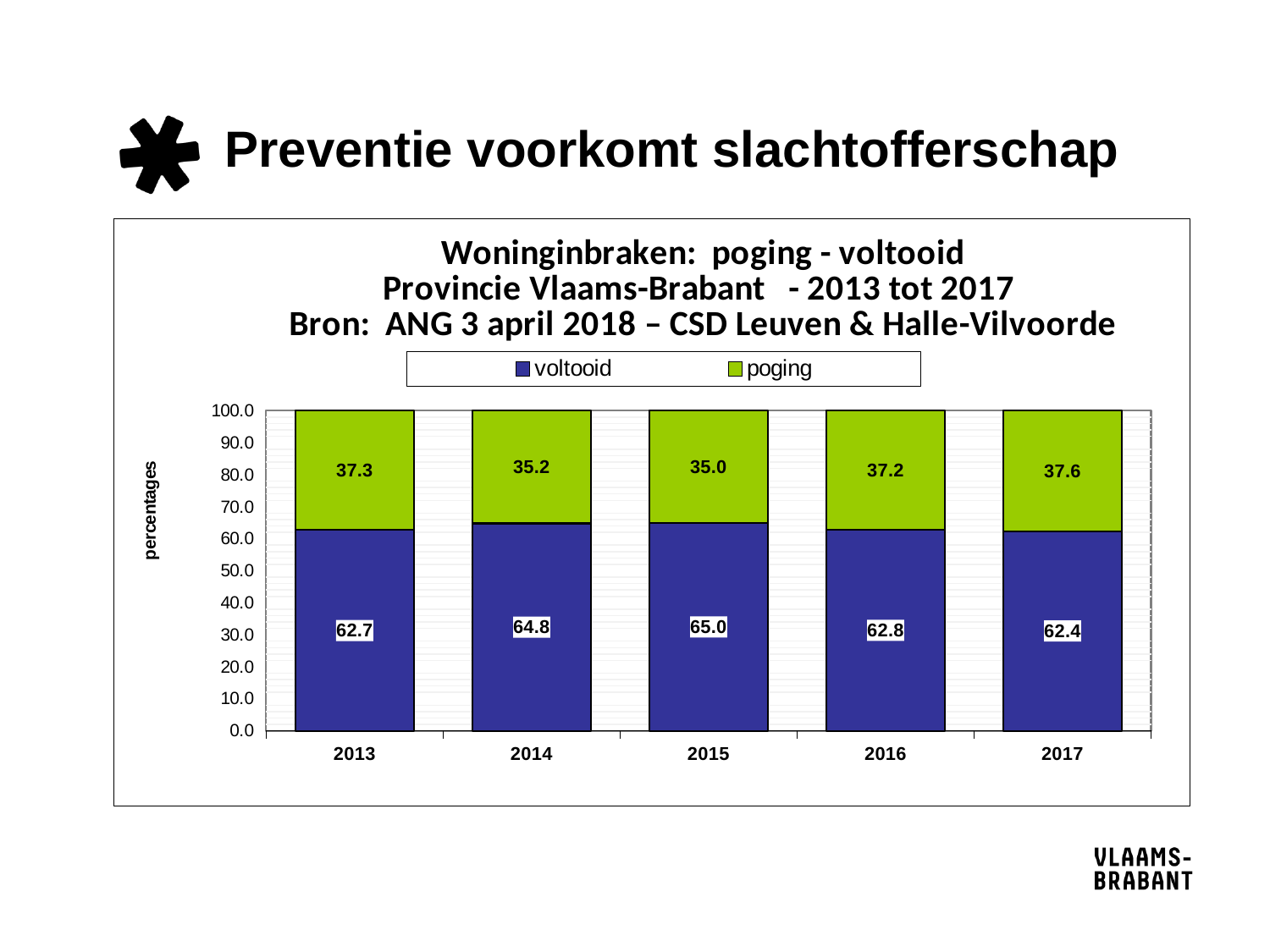
Which year has the lowest value for voltooid? 2017 What is the difference between the voltooid values for 2014 and 2017? 2.4 What is the value for voltooid in 2015? 65.0 How many years are shown on the x axis? 5 Which year has the lowest value for poging? 2015 How many series does the legend list? 2 What is the value for voltooid in 2013? 62.7 What is the value for poging in 2017? 37.6 Which is larger, the poging value for 2013 or for 2014? 2013 Which year has the highest value for voltooid? 2015 What kind of chart is shown? Stacked bar chart What is the total of the stacked bar for 2016? 100.0